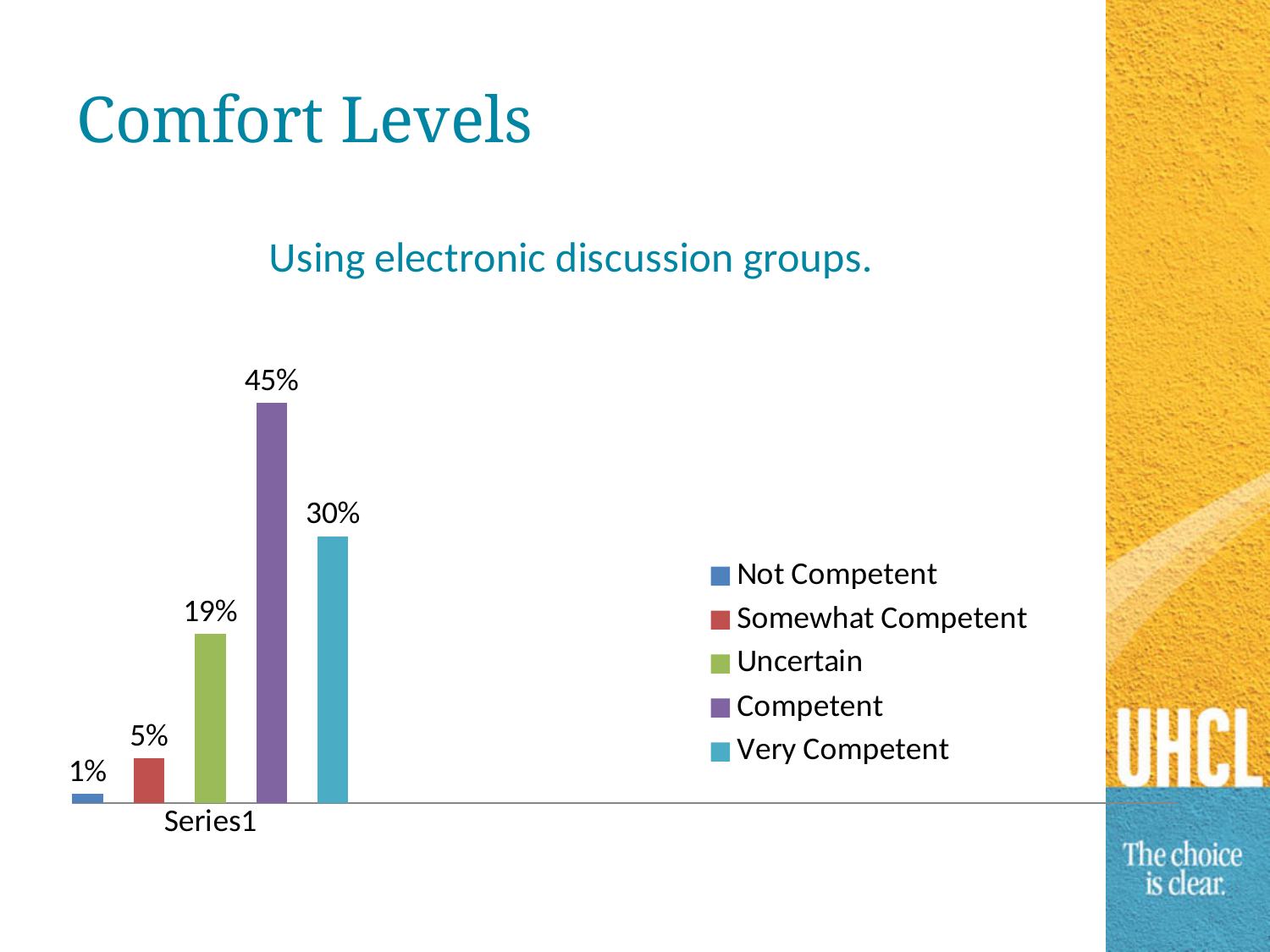
What is the value for Uncertain? 19% What is the value for Competent? 45% Which legend entry has the highest value? Competent How many series does the legend list? 5 What is the difference between the values for Uncertain and Somewhat Competent? 14% What is the value for Not Competent? 1% Which is larger, the value for Uncertain or the value for Somewhat Competent? Uncertain What is the value for Very Competent? 30% What kind of chart is shown on the slide? Bar chart What is the difference between the values for Competent and Very Competent? 15% Which legend entry has the lowest value? Not Competent What is the category label shown on the x axis? Series1